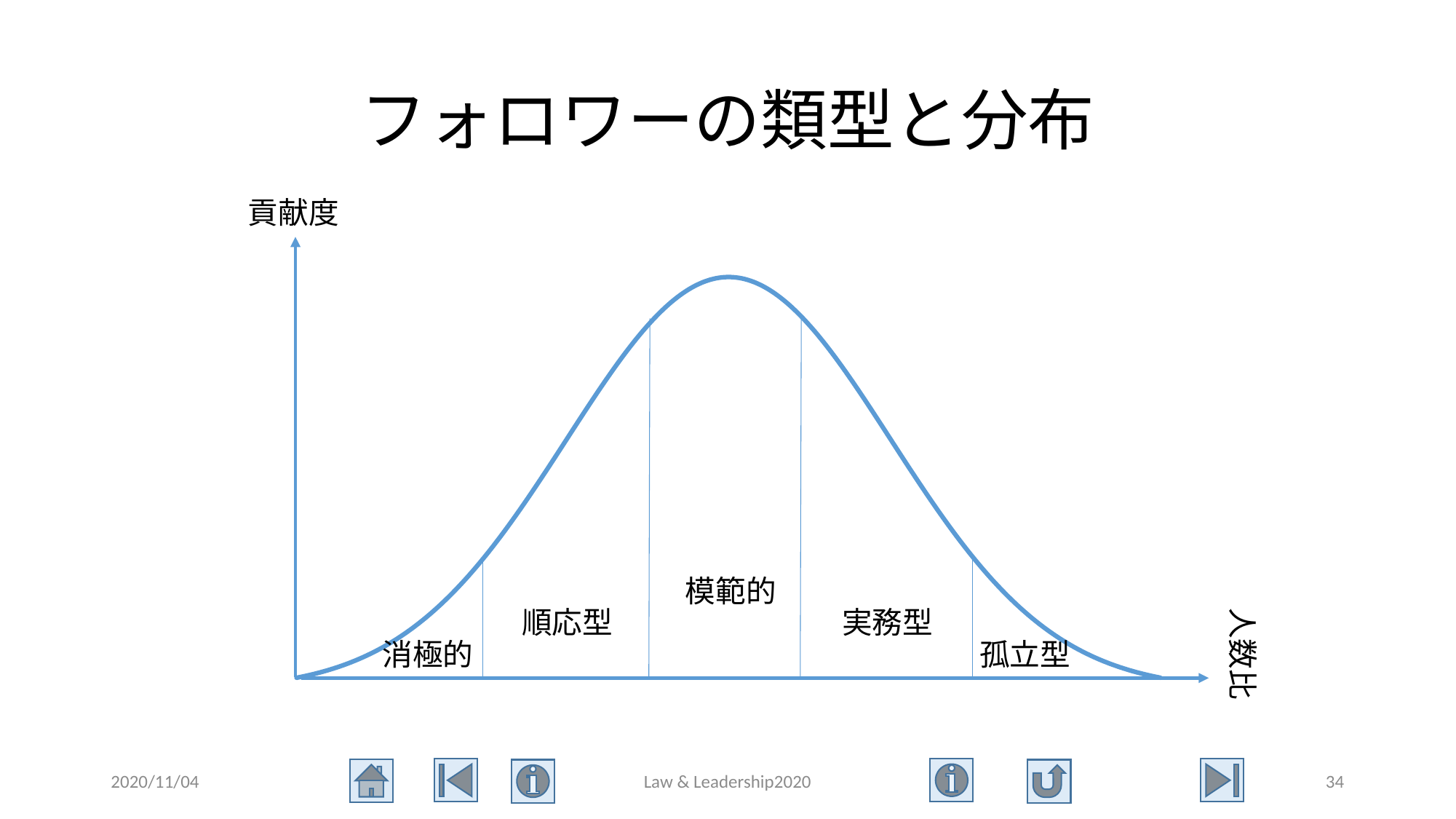
Which follower type is located at the peak of the curve? 模範的 What kind of chart is shown on the slide? A line chart (bell curve) Does the curve rise or fall moving from the left edge toward the centre of the x axis? Rise Which follower type is labelled in the leftmost segment of the curve? 消極的 Does the curve rise or fall moving from the centre toward the right end of the x axis? Fall What is the label on the vertical axis? 貢献度 Which follower type is labelled between 模範的 and 孤立型? 実務型 Which follower type is labelled in the rightmost segment of the curve? 孤立型 Which follower type is labelled between 消極的 and 模範的? 順応型 What is the label on the horizontal axis? 人数比 How many follower types are labelled along the curve? 5